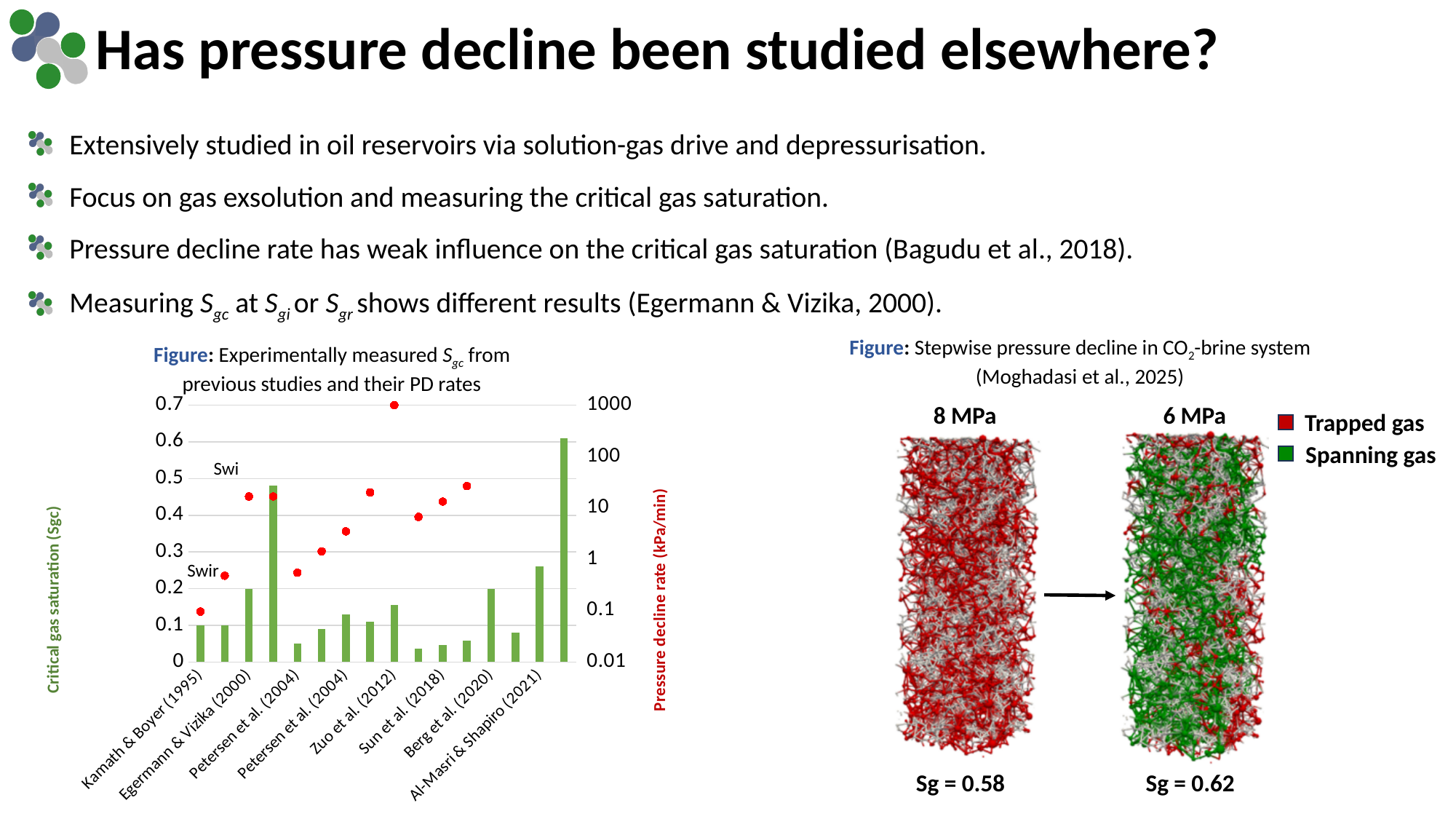
Which study has the lowest pressure decline rate (red dot) in the chart? Kamath & Boyer (1995) What kind of chart is shown on the left of the slide? bar chart with scatter points Is the critical gas saturation bar labelled Al-Masri & Shapiro (2021) greater or less than 0.2? greater How many green bars are plotted in the chart? 16 Is the pressure decline rate (red dot) for Zuo et al. (2012) greater or less than 100 kPa/min? greater Which study has the highest pressure decline rate (red dot) in the chart? Zuo et al. (2012) Is the critical gas saturation bar for Kamath & Boyer (1995) greater or less than 0.2? less What is the title of the left vertical axis of the chart? Critical gas saturation (Sgc) What is the title of the right vertical axis of the chart? Pressure decline rate (kPa/min) Which has the larger critical gas saturation bar: Kamath & Boyer (1995) or Al-Masri & Shapiro (2021)? Al-Masri & Shapiro (2021)